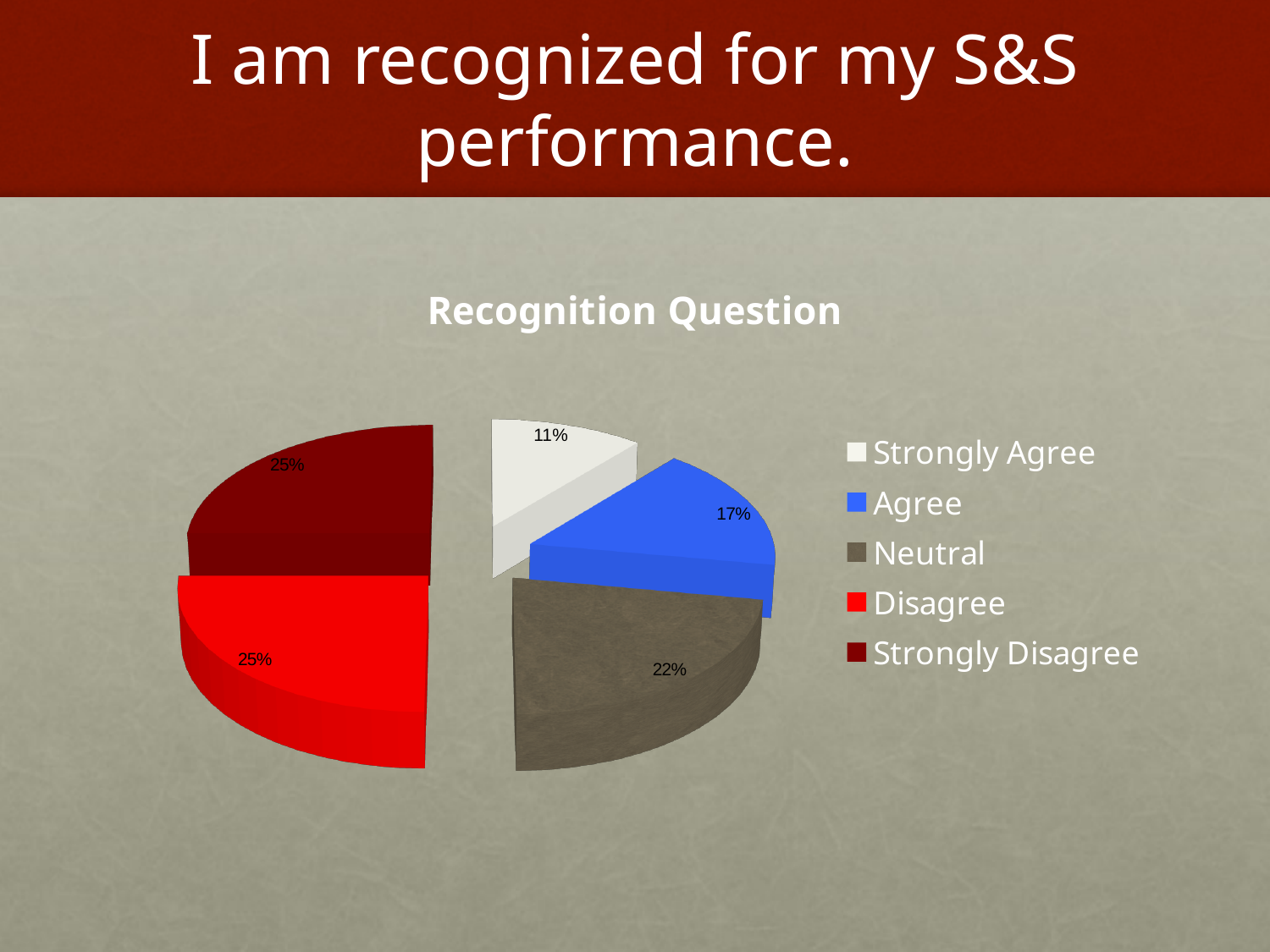
What percentage of respondents answered Disagree? 25% What percentage of respondents answered Neutral? 22% What is the difference in percentage points between Disagree and Agree? 8 What is the title of the chart? Recognition Question What percentage of respondents answered Strongly Disagree? 25% How many response categories does the pie chart show? 5 Which is larger, the share for Neutral or the share for Agree? Neutral What percentage of respondents answered Agree? 17% What percentage of respondents answered Strongly Agree? 11% What is the difference in percentage points between Neutral and Strongly Agree? 11 Which response category has the smallest share of the pie? Strongly Agree What kind of chart is shown on the slide? Pie chart